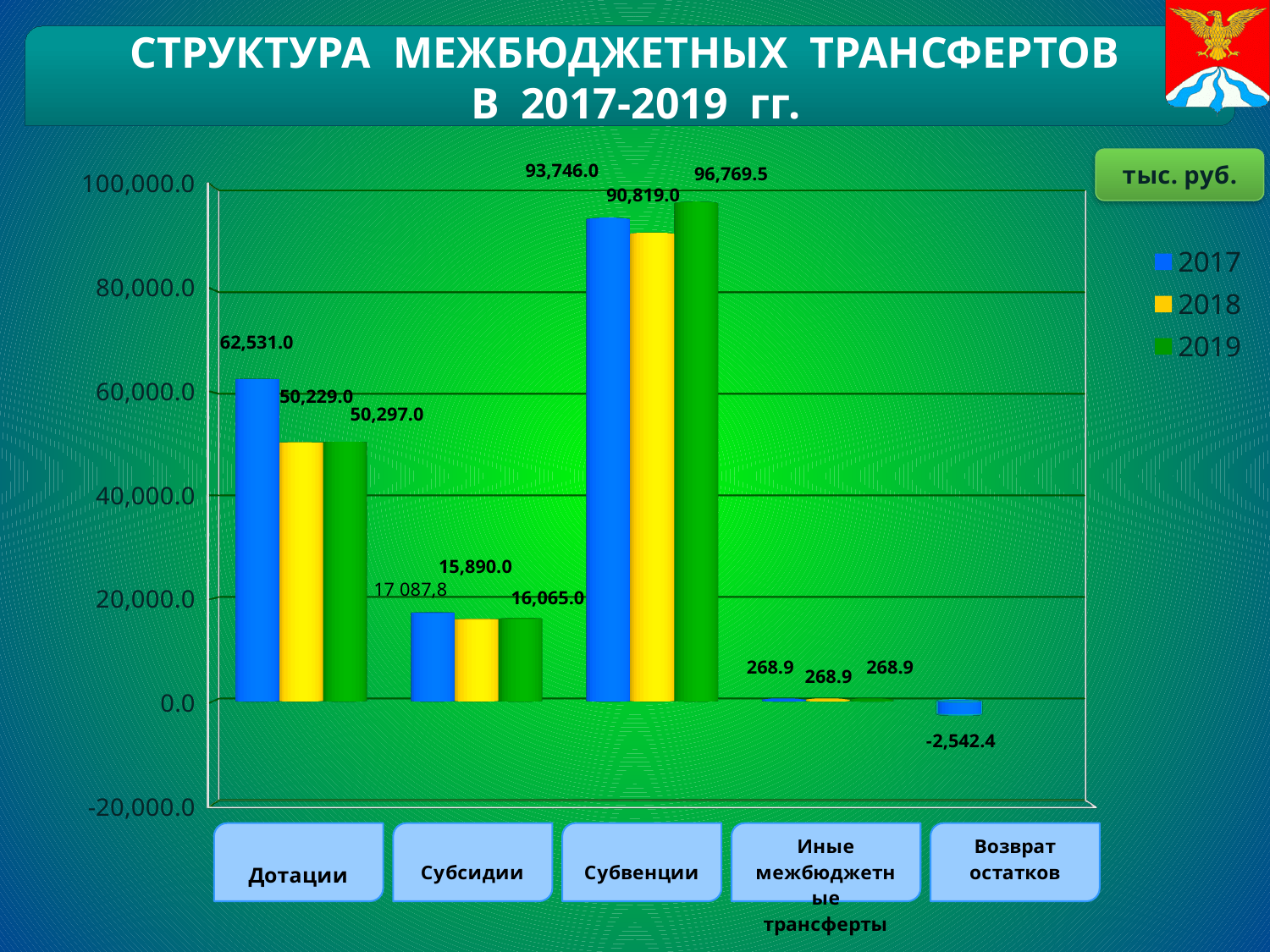
How many categories are shown on the x axis? 5 What is the difference between the 2019 and 2018 values for Субвенции? 5,950.5 Which is larger for Субвенции: the 2017 value or the 2018 value? 2017 What is the difference between the 2017 and 2018 values for Дотации? 12,302.0 How many series does the legend list? 3 What is the value for Субсидии in 2018? 15,890.0 What is the value for Возврат остатков in 2017? -2,542.4 Which category has the highest value for the 2019 series? Субвенции What is the value for Дотации in 2017? 62,531.0 Which category has the lowest value for the 2017 series? Возврат остатков What is the value for Субвенции in 2019? 96,769.5 What kind of chart is shown on the slide? Bar chart